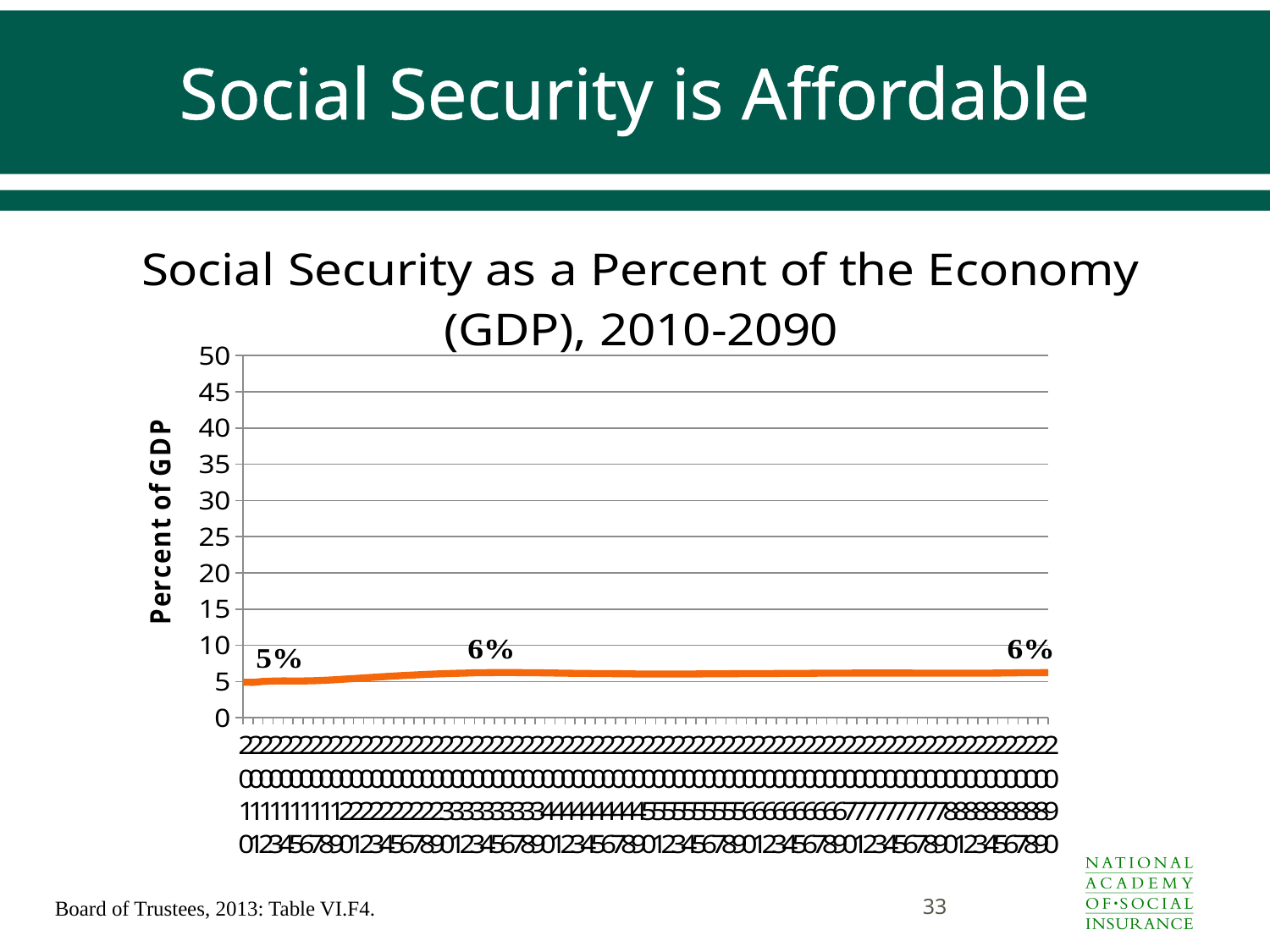
Is the value for 2070 greater or less than 15? less What value is labelled at the end of the line, in 2090? 6% What is the difference between the labelled value for 2090 and the labelled value for 2010? 1% What is the title of the chart? Social Security as a Percent of the Economy (GDP), 2010-2090 What value is labelled at the start of the line, in 2010? 5% Which is larger, the labelled value for 2010 or the labelled value for 2090? 2090 What is the label on the vertical axis of the chart? Percent of GDP Does the line rise or fall from 2010 to 2090 overall? rise What value is labelled at the middle of the line, around the 2030s? 6% Is the value for 2050 greater or less than 10? less What kind of chart is shown on the slide? line chart What is the highest tick value shown on the vertical axis? 50